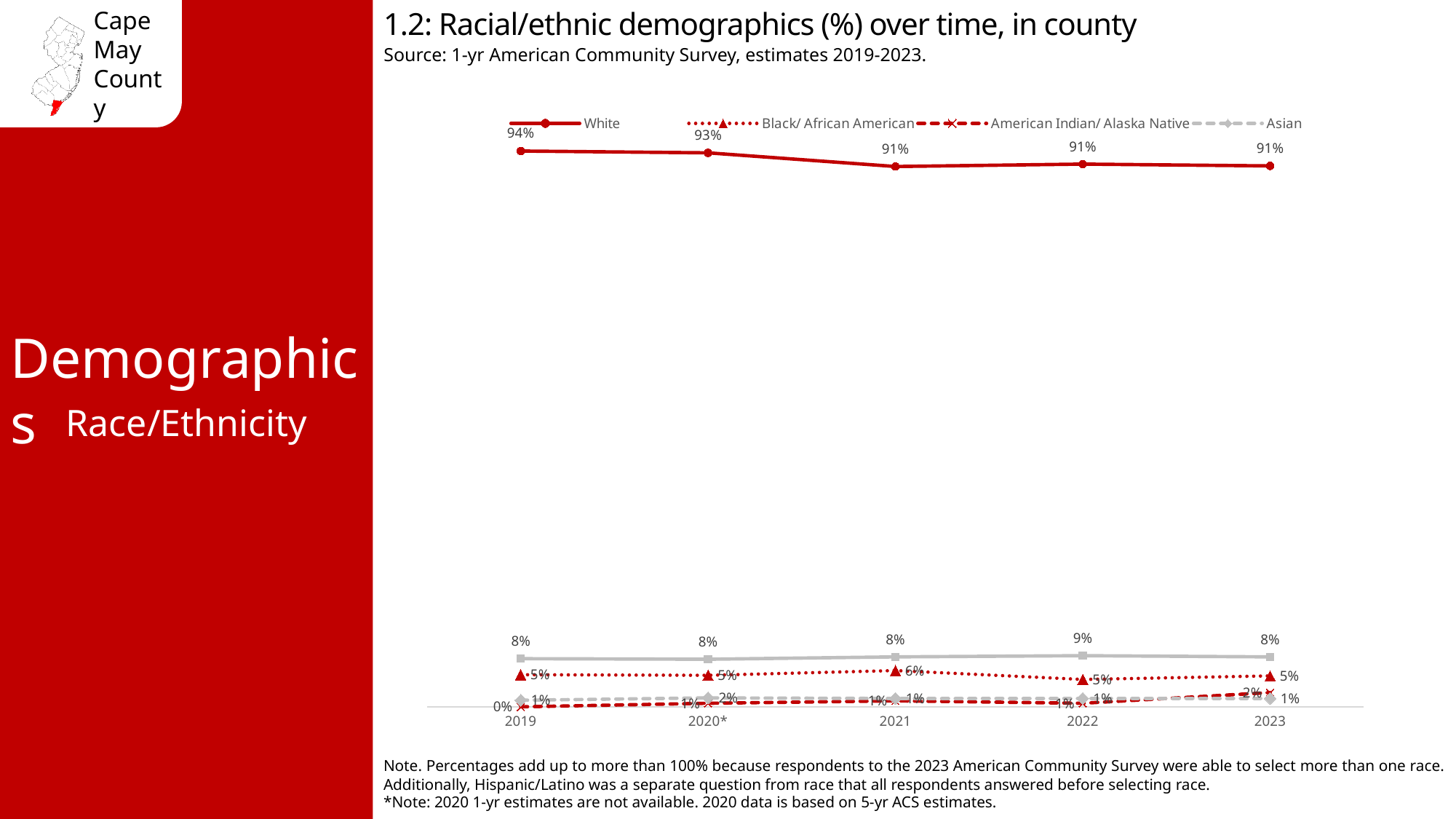
What percentage is shown for Black/ African American in 2021? 6% How many series does the legend list? 4 What percentage is shown for White in 2023? 91% Which year has a higher White percentage, 2019 or 2020*? 2019 How many years are plotted on the x axis? 5 By how many percentage points did the White share fall from 2019 to 2023? 3% In which year is the Black/ African American percentage highest? 2021 What kind of chart is shown on the slide? Line chart What percentage is shown for White in 2019? 94% What percentage is shown for Asian in 2020*? 2% In which year is the White percentage highest? 2019 What percentage is shown for American Indian/ Alaska Native in 2019? 0%